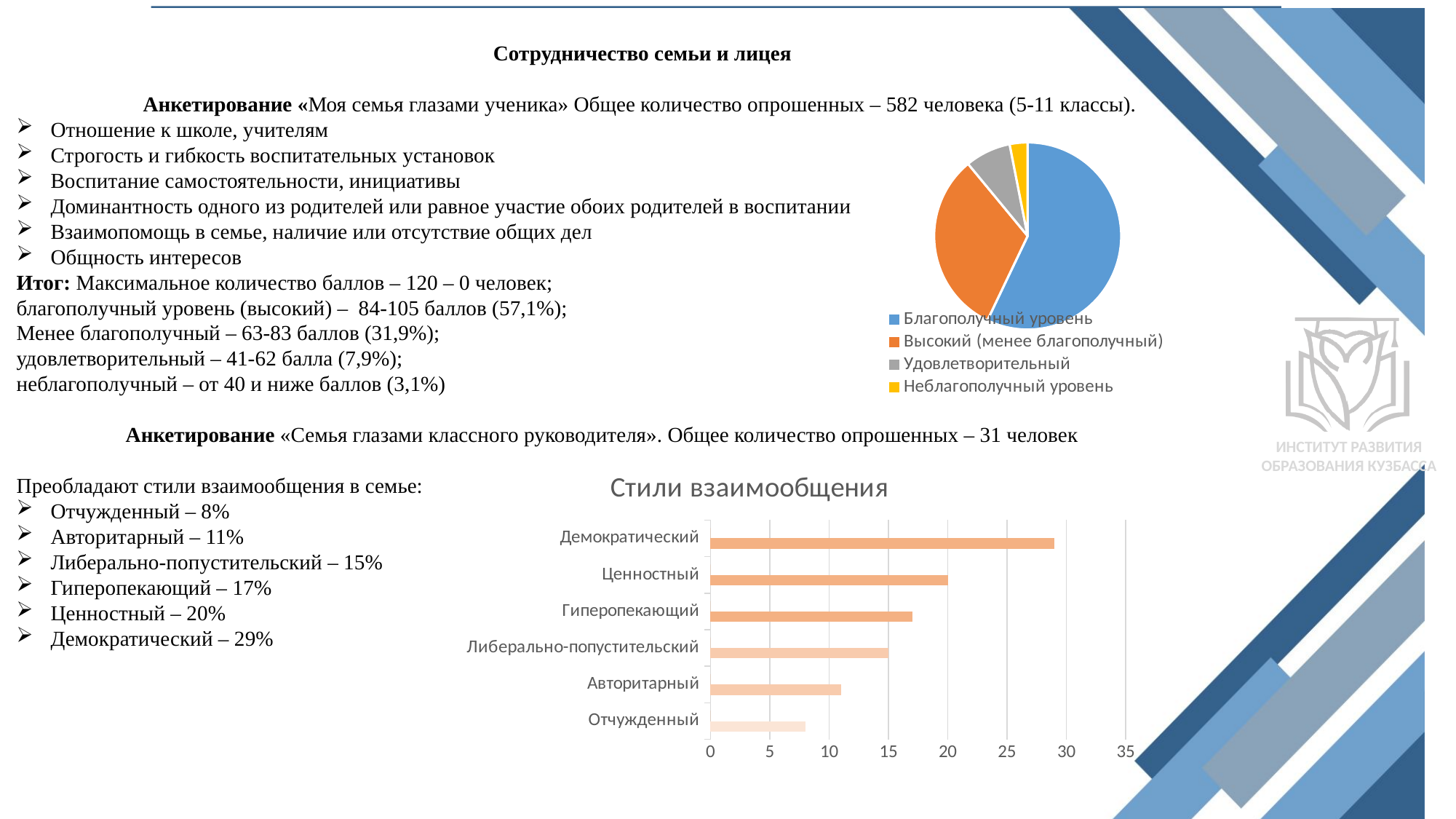
In the chart "Стили взаимообщения", what is the value for Либерально-попустительский? 15 In the chart "Стили взаимообщения", is the value for Отчужденный greater or less than 10? less What kind of chart is the chart titled "Стили взаимообщения"? bar chart In the chart "Стили взаимообщения", what is the difference between the values for Ценностный and Либерально-попустительский? 5 In the chart "Стили взаимообщения", what is the value for Ценностный? 20 In the chart "Стили взаимообщения", which is larger, the value for Гиперопекающий or the value for Авторитарный? Гиперопекающий In the chart "Стили взаимообщения", how many categories are shown? 6 In the chart "Стили взаимообщения", which category has the lowest value? Отчужденный In the pie chart at the top right of the slide, which category has the largest slice? Благополучный уровень In the chart "Стили взаимообщения", which category has the highest value? Демократический In the chart "Стили взаимообщения", is the value for Демократический greater or less than 25? greater How many entries does the legend of the pie chart at the top right of the slide list? 4